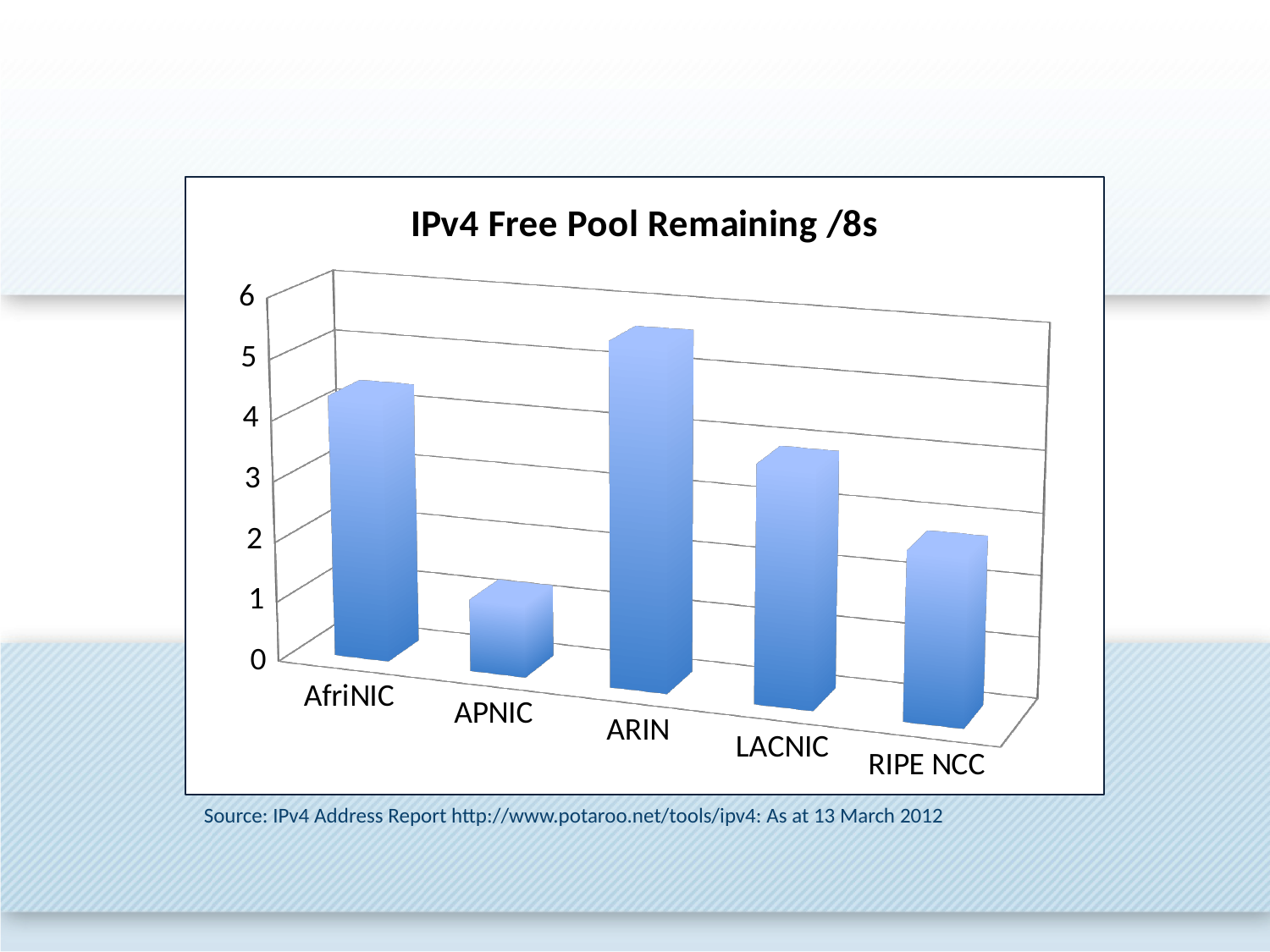
What kind of chart is shown on the slide? bar chart Is the value for RIPE NCC greater or less than 3? less Is the value for APNIC greater or less than 2? less Which category has the highest value in the chart? ARIN Which has a larger value, RIPE NCC or APNIC? RIPE NCC Is the value for LACNIC greater or less than 4? less What is the title of the chart? IPv4 Free Pool Remaining /8s Which has a larger value, AfriNIC or LACNIC? AfriNIC Which category has the lowest value in the chart? APNIC How many categories are shown on the x axis of the chart? 5